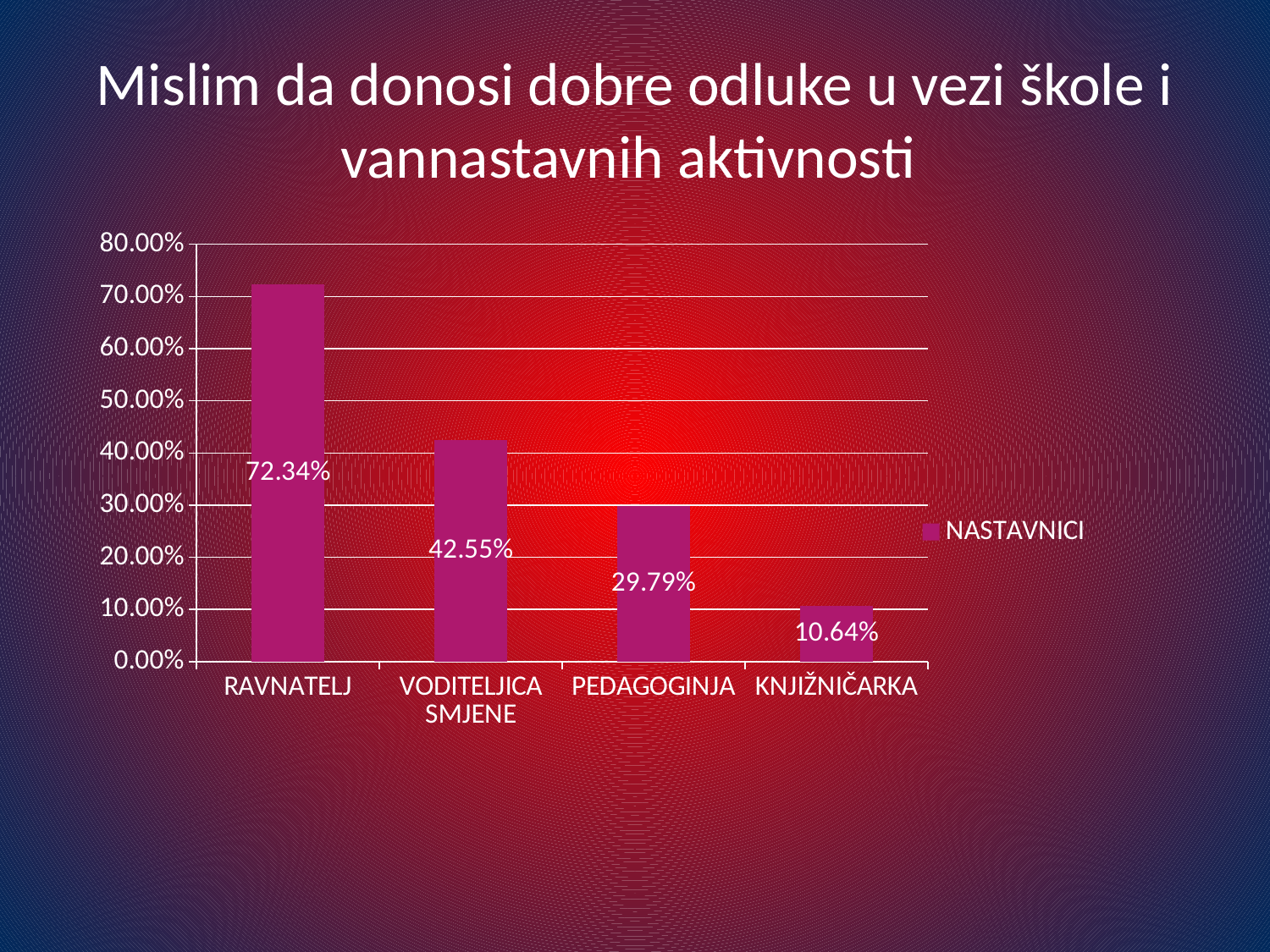
What is the value for RAVNATELJ? 72.34% Which category has the highest value? RAVNATELJ What is the difference between the values for RAVNATELJ and VODITELJICA SMJENE? 29.79% What kind of chart is shown on the slide? bar chart How many series does the legend list? 1 Is the value for VODITELJICA SMJENE greater or less than 40.00%? greater Which is larger, the value for PEDAGOGINJA or the value for KNJIŽNIČARKA? PEDAGOGINJA What is the value for VODITELJICA SMJENE? 42.55% What is the value for PEDAGOGINJA? 29.79% Which category has the lowest value? KNJIŽNIČARKA What is the value for KNJIŽNIČARKA? 10.64% How many categories are shown on the x axis? 4